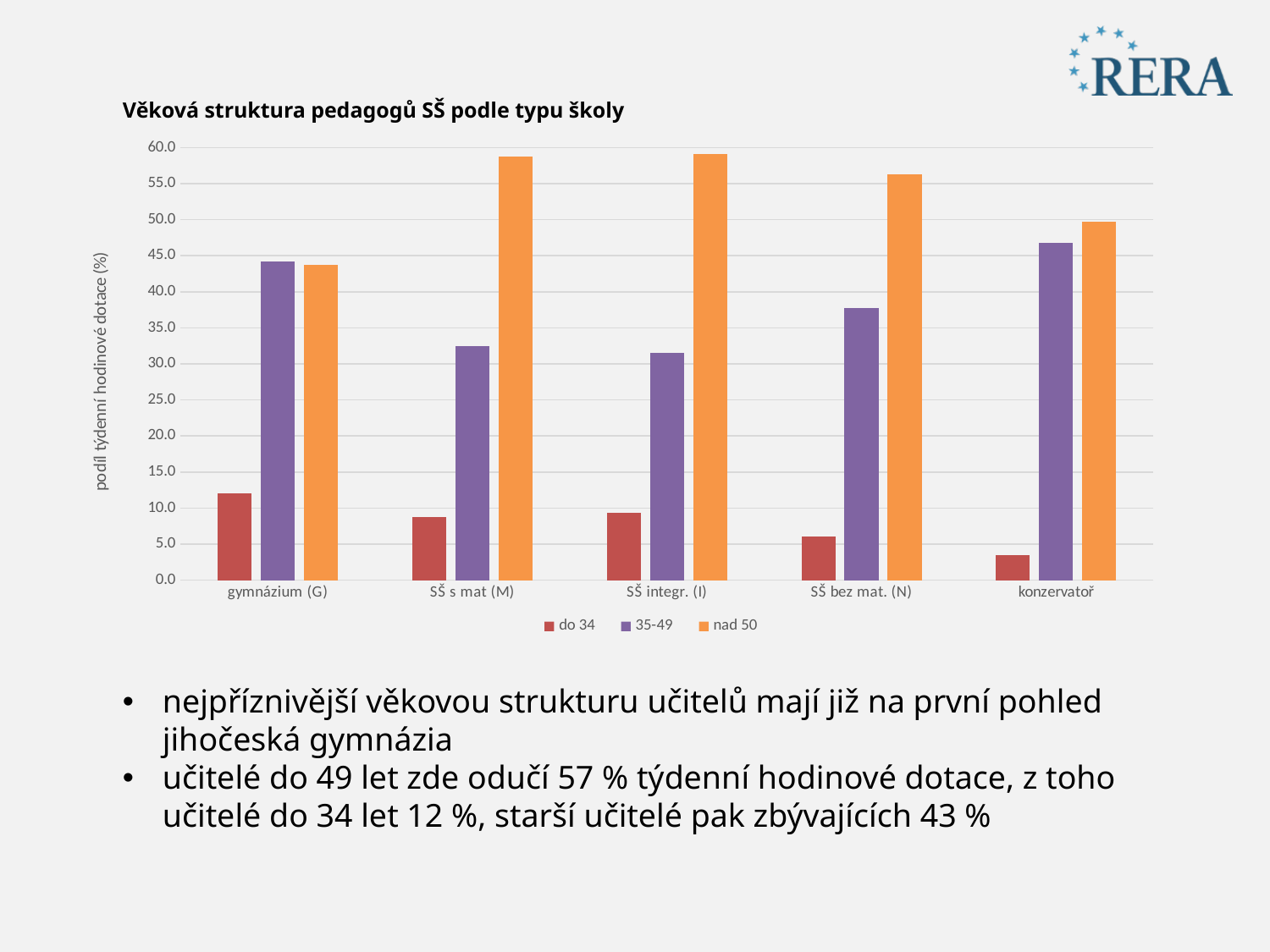
Is the value for 'do 34' at gymnázium (G) greater or less than 10.0? greater How many school types (categories) are shown on the x axis? 5 Which school type has the lowest value for the 'do 34' series? konzervatoř What is the title of the chart? Věková struktura pedagogů SŠ podle typu školy Is the value for 'nad 50' at SŠ s mat (M) greater or less than 55.0? greater For SŠ bez mat. (N), which series has the larger value: '35-49' or 'nad 50'? nad 50 What is the label of the vertical axis? podíl týdenní hodinové dotace (%) Which school type has the highest value for the 'do 34' series? gymnázium (G) Is the value for 'do 34' at konzervatoř greater or less than 5.0? less What kind of chart is shown on the slide? bar chart How many series does the legend list? 3 Which school type has the lowest value for the 'nad 50' series? gymnázium (G)